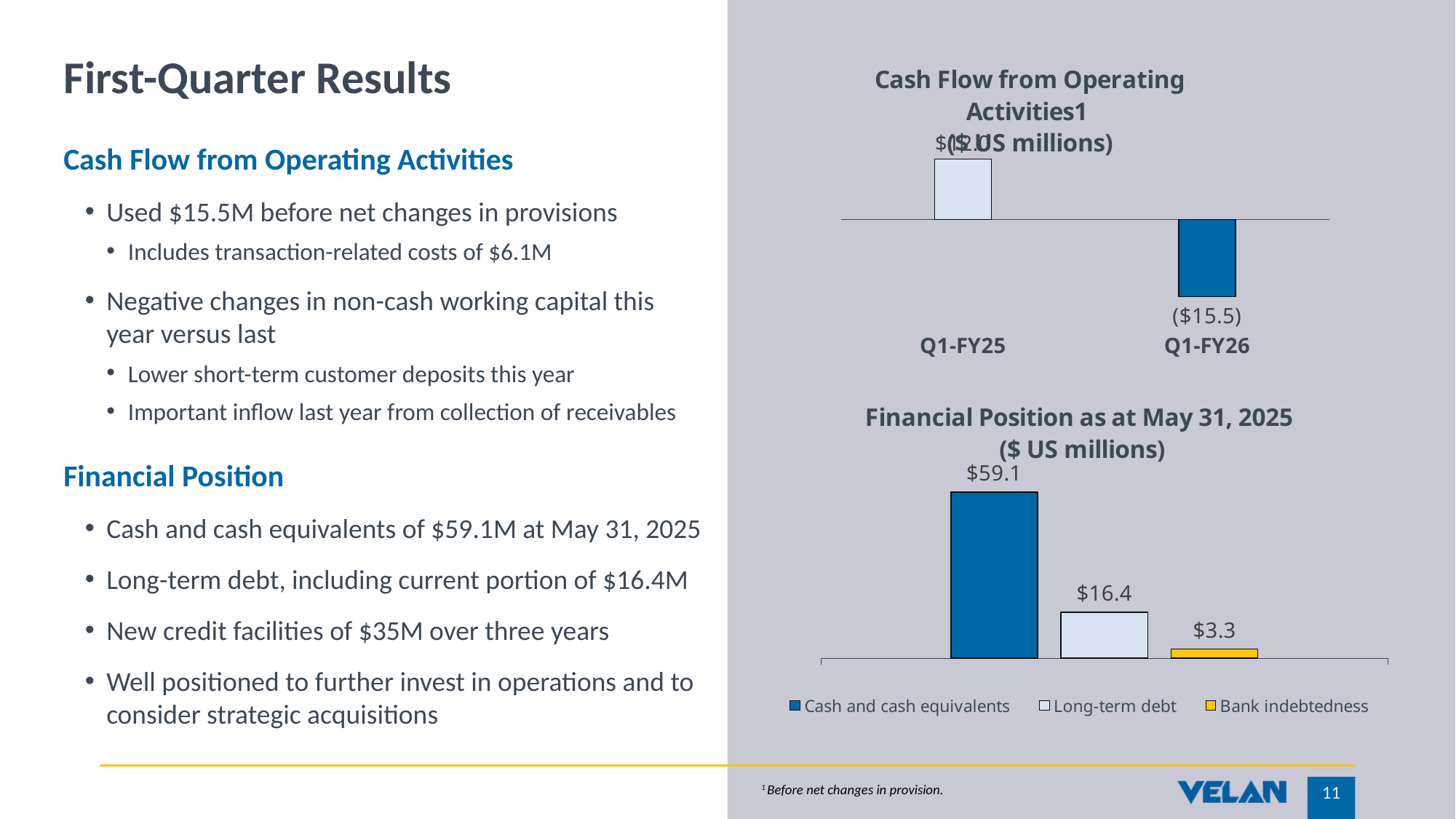
In the Cash Flow from Operating Activities chart, how many quarters are plotted? 2 In the Financial Position as at May 31, 2025 chart, what is the value for Long-term debt? $16.4 In the Financial Position as at May 31, 2025 chart, what is the value for Bank indebtedness? $3.3 How many series does the legend of the Financial Position as at May 31, 2025 chart list? 3 In the Cash Flow from Operating Activities chart, is the Q1-FY26 bar above or below the zero line? below In the Financial Position as at May 31, 2025 chart, which item has the highest value? Cash and cash equivalents In the Financial Position as at May 31, 2025 chart, which item has the lowest value? Bank indebtedness In the Financial Position as at May 31, 2025 chart, what is the difference between Cash and cash equivalents and Long-term debt? $42.7 In the Cash Flow from Operating Activities chart, which quarter has the higher cash flow, Q1-FY25 or Q1-FY26? Q1-FY25 What kind of chart is the Cash Flow from Operating Activities chart? bar chart In the Cash Flow from Operating Activities chart, what is the value for Q1-FY26? ($15.5) In the Financial Position as at May 31, 2025 chart, what is the value for Cash and cash equivalents? $59.1